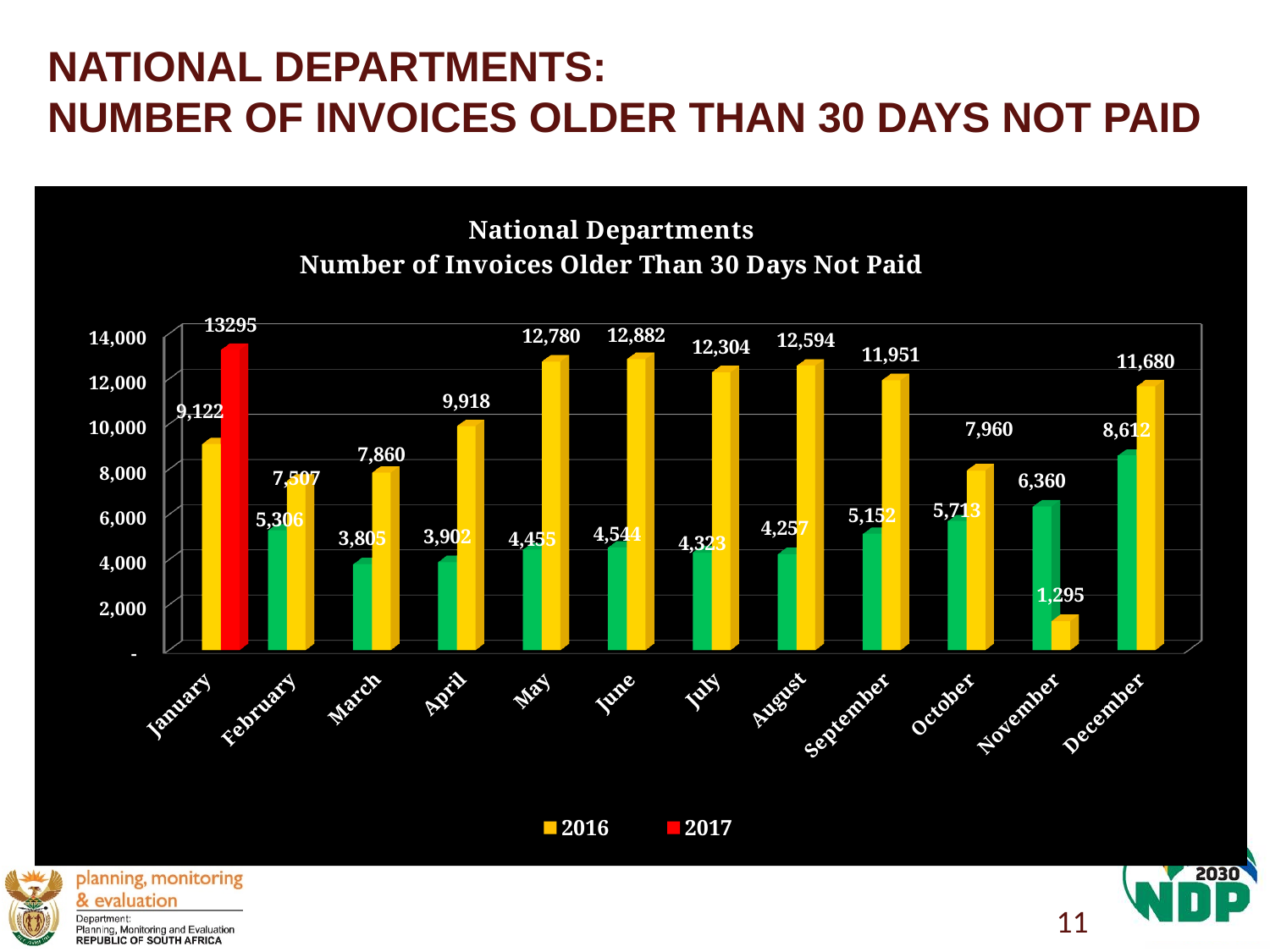
How many months are shown on the x axis? 12 What is the 2016 value for November? 1,295 What is the difference between the 2017 and 2016 values for January? 4,173 Which month has the highest 2016 value? June Is the 2016 value for April greater or less than 8,000? greater What is the title of the chart? National Departments Number of Invoices Older Than 30 Days Not Paid How many series does the legend list? 2 What type of chart is shown on the slide? bar chart What is the 2017 value for January? 13295 Which is larger, the 2016 value for May or the 2016 value for August? May Which month has the lowest 2016 value? November What is the 2016 value for June? 12,882